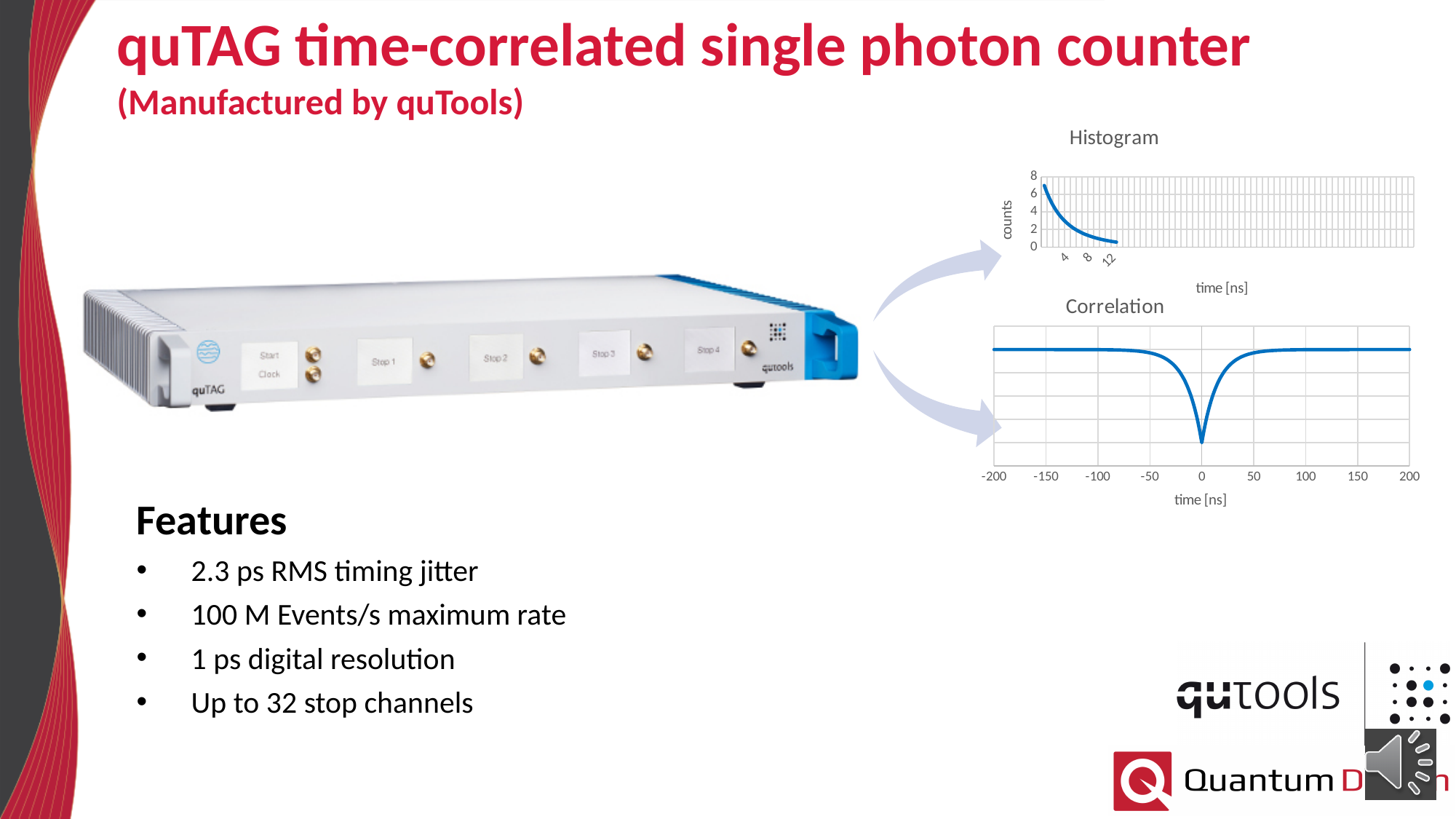
What kind of chart is the Correlation chart? line chart In the Histogram chart, is the value at the start of the curve greater or less than 6? greater In the Histogram chart, is the value at time 12 ns greater or less than 2? less What is the label of the y axis of the Histogram chart? counts What kind of chart is the Histogram chart? line chart In the Correlation chart, at what time [ns] does the curve reach its lowest point? 0 What is the highest tick value on the y axis of the Histogram chart? 8 In the Correlation chart, what is the lowest value shown on the x axis? -200 In the Histogram chart, do the counts rise or fall as time increases? fall How many tick labels are shown on the x axis of the Correlation chart? 9 What is the label of the x axis of the Correlation chart? time [ns] In the Correlation chart, what is the highest value shown on the x axis? 200